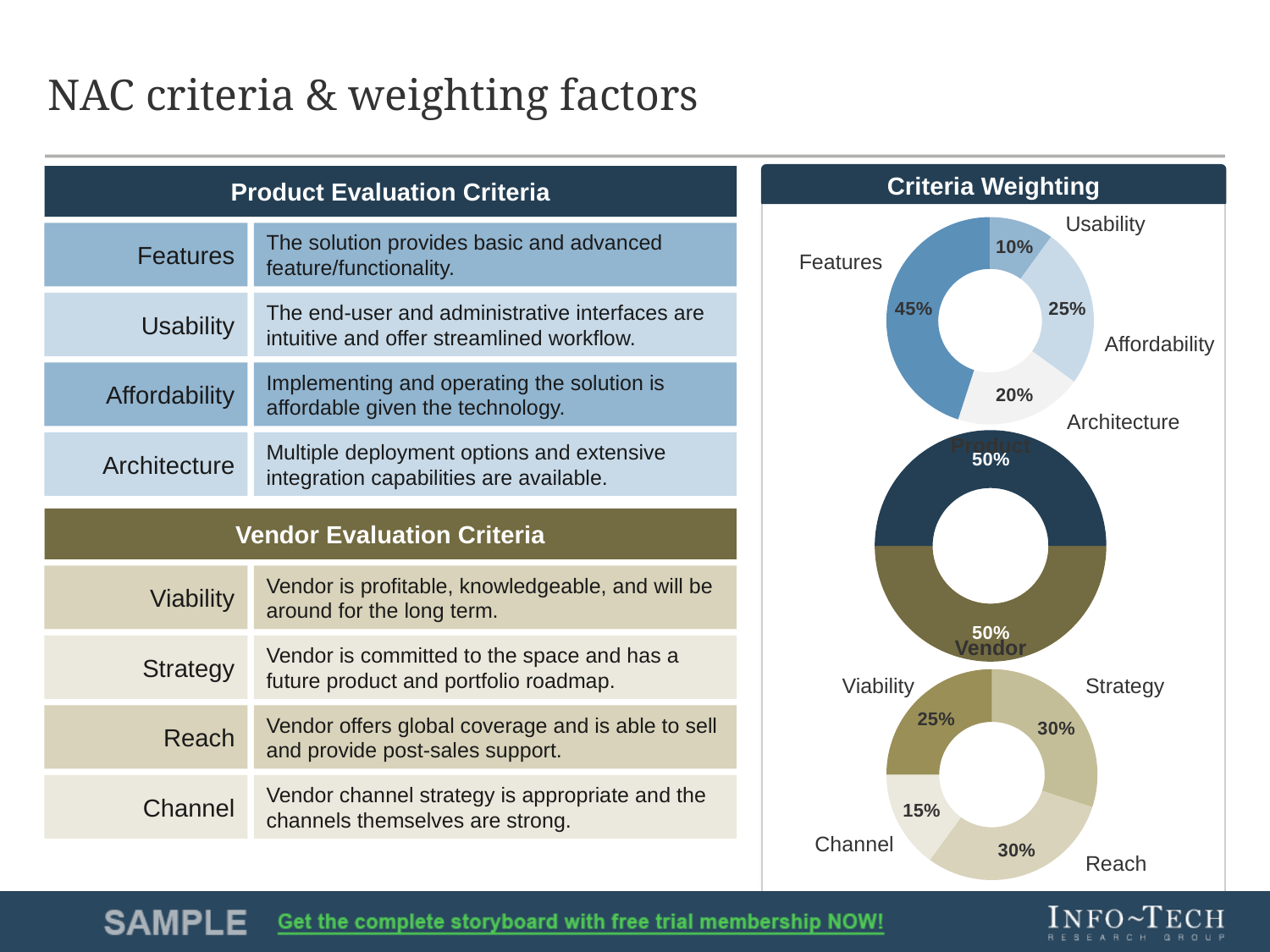
In the bottom donut chart under Criteria Weighting, what is the weighting for Channel? 15% In the bottom donut chart under Criteria Weighting, which is larger, the weighting for Viability or for Strategy? Strategy In the bottom donut chart under Criteria Weighting, which criterion has the lowest weighting? Channel What kind of chart is used in the Criteria Weighting section? Donut chart In the top donut chart under Criteria Weighting, what is the weighting for Usability? 10% In the top donut chart under Criteria Weighting, which criterion has the lowest weighting? Usability In the top donut chart under Criteria Weighting, how many criteria are shown? 4 In the bottom donut chart under Criteria Weighting, what is the difference between the Reach and Channel weightings? 15% In the top donut chart under Criteria Weighting, which criterion has the highest weighting? Features In the middle donut chart under Criteria Weighting, what is the weighting for Vendor? 50% In the top donut chart under Criteria Weighting, what is the weighting for Features? 45% In the top donut chart under Criteria Weighting, what is the difference between the Affordability and Architecture weightings? 5%